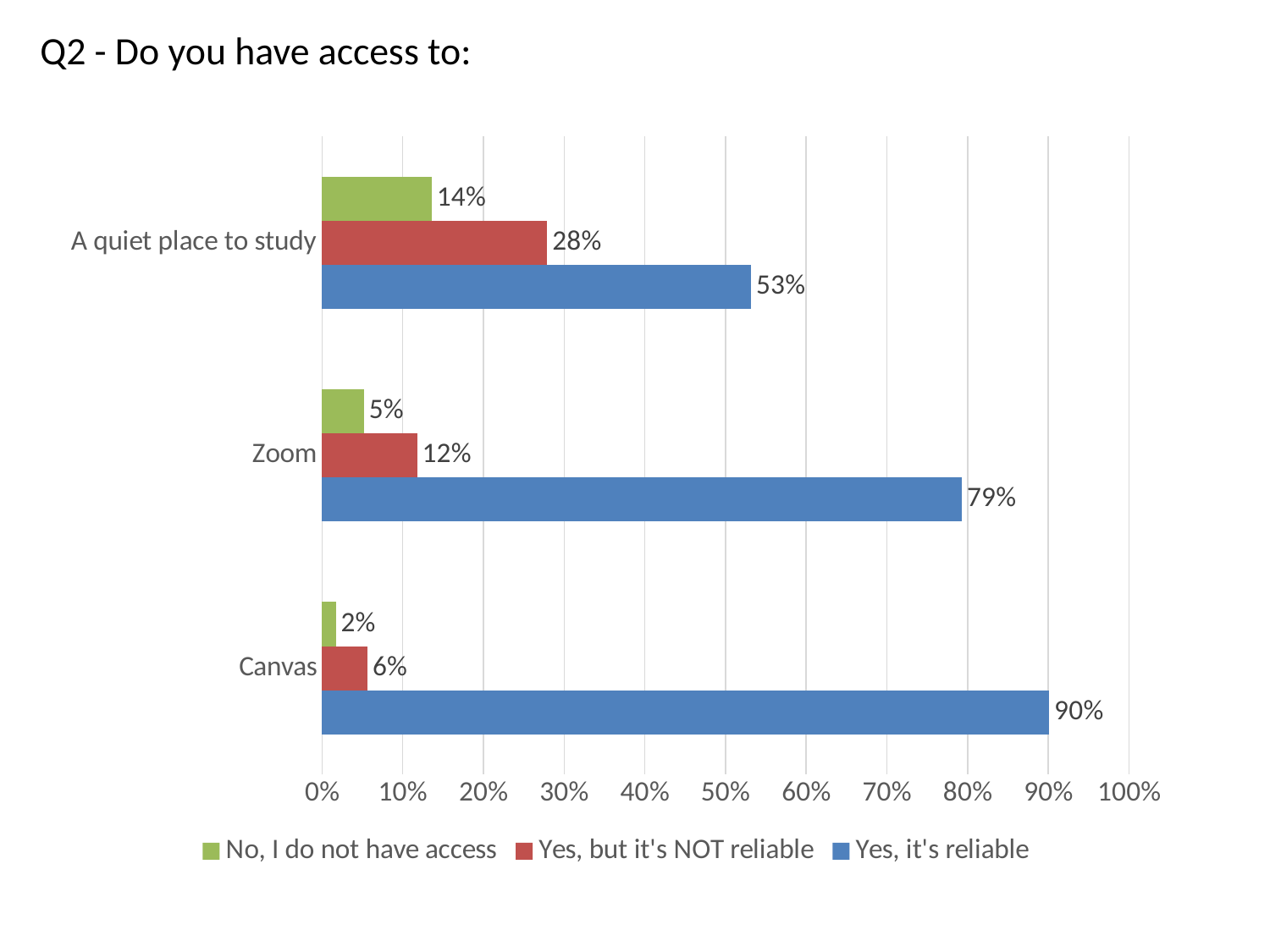
What is the total of the three values for A quiet place to study? 95% Which is larger: the 'Yes, but it's NOT reliable' value for Zoom or for A quiet place to study? A quiet place to study How many series does the legend list? 3 What is the difference between the 'Yes, it's reliable' values for Canvas and Zoom? 11% What kind of chart is shown on the slide? Bar chart Which category has the highest value for 'Yes, it's reliable'? Canvas How many categories are shown on the chart? 3 Which category has the lowest value for 'No, I do not have access'? Canvas What colour represents the 'Yes, it's reliable' series? Blue What is the value for 'Yes, but it's NOT reliable' for A quiet place to study? 28% What percentage of respondents said they have reliable access to Canvas? 90% What percentage said 'No, I do not have access' for Zoom? 5%